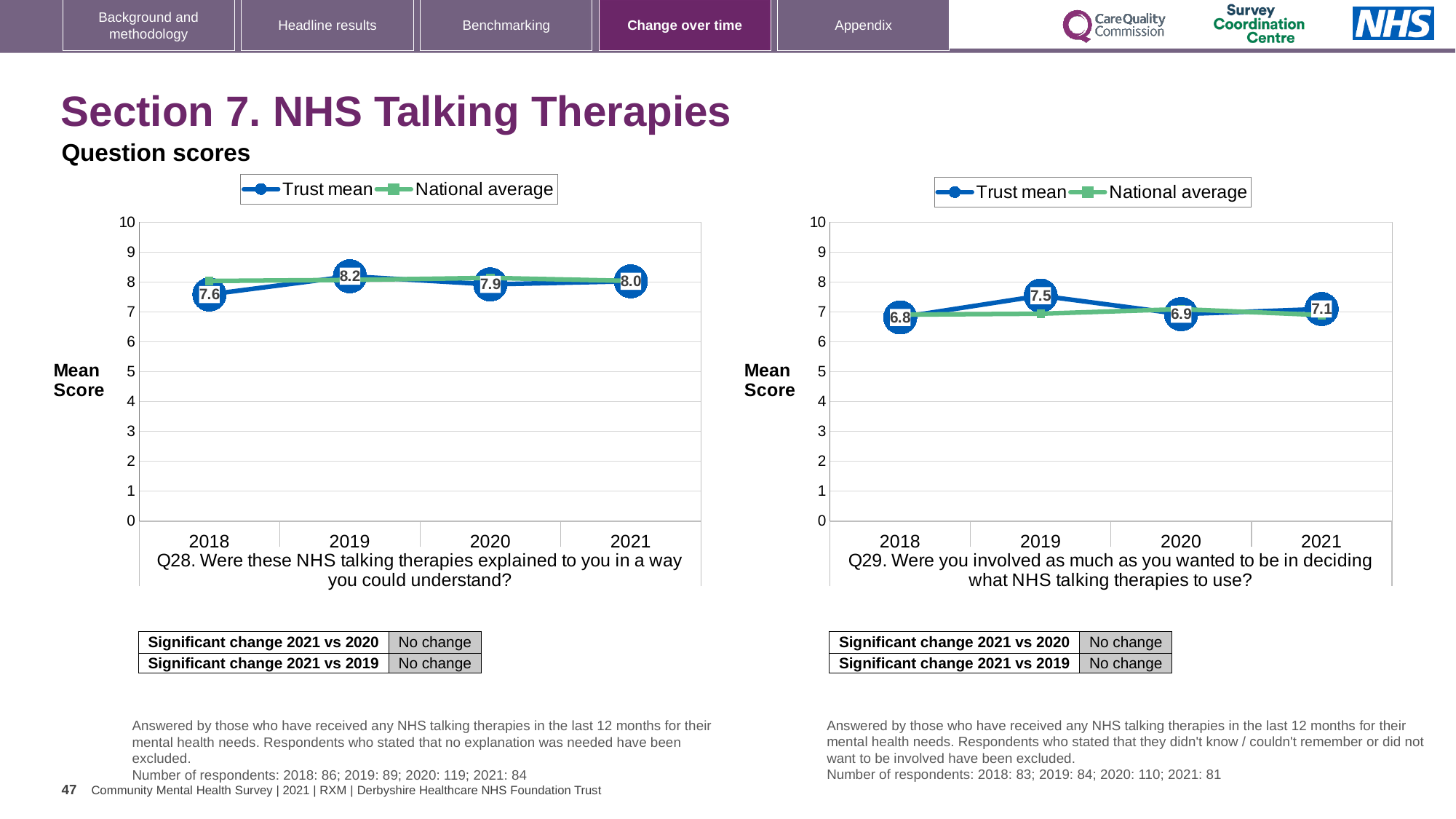
How many series does the legend of the Q28 chart on the left list? 2 In the Q28 chart on the left, what is the Trust mean score for 2019? 8.2 In the Q28 chart on the left, is the Trust mean score for 2020 greater or less than 7? greater In the Q28 chart on the left, which year has the highest Trust mean score? 2019 In the Q29 chart on the right, what is the Trust mean score for 2018? 6.8 In the Q28 chart on the left, what is the difference between the Trust mean scores for 2019 and 2018? 0.6 In the Q28 chart on the left, what is the Trust mean score for 2018? 7.6 In the Q29 chart on the right, which year has the lowest Trust mean score? 2018 In the Q29 chart on the right, what is the Trust mean score for 2021? 7.1 What kind of chart is the Q29 chart on the right? Line chart In the Q29 chart on the right, what is the difference between the Trust mean scores for 2019 and 2020? 0.6 In the Q29 chart on the right, is the Trust mean score for 2019 larger or smaller than the Trust mean score for 2021? larger